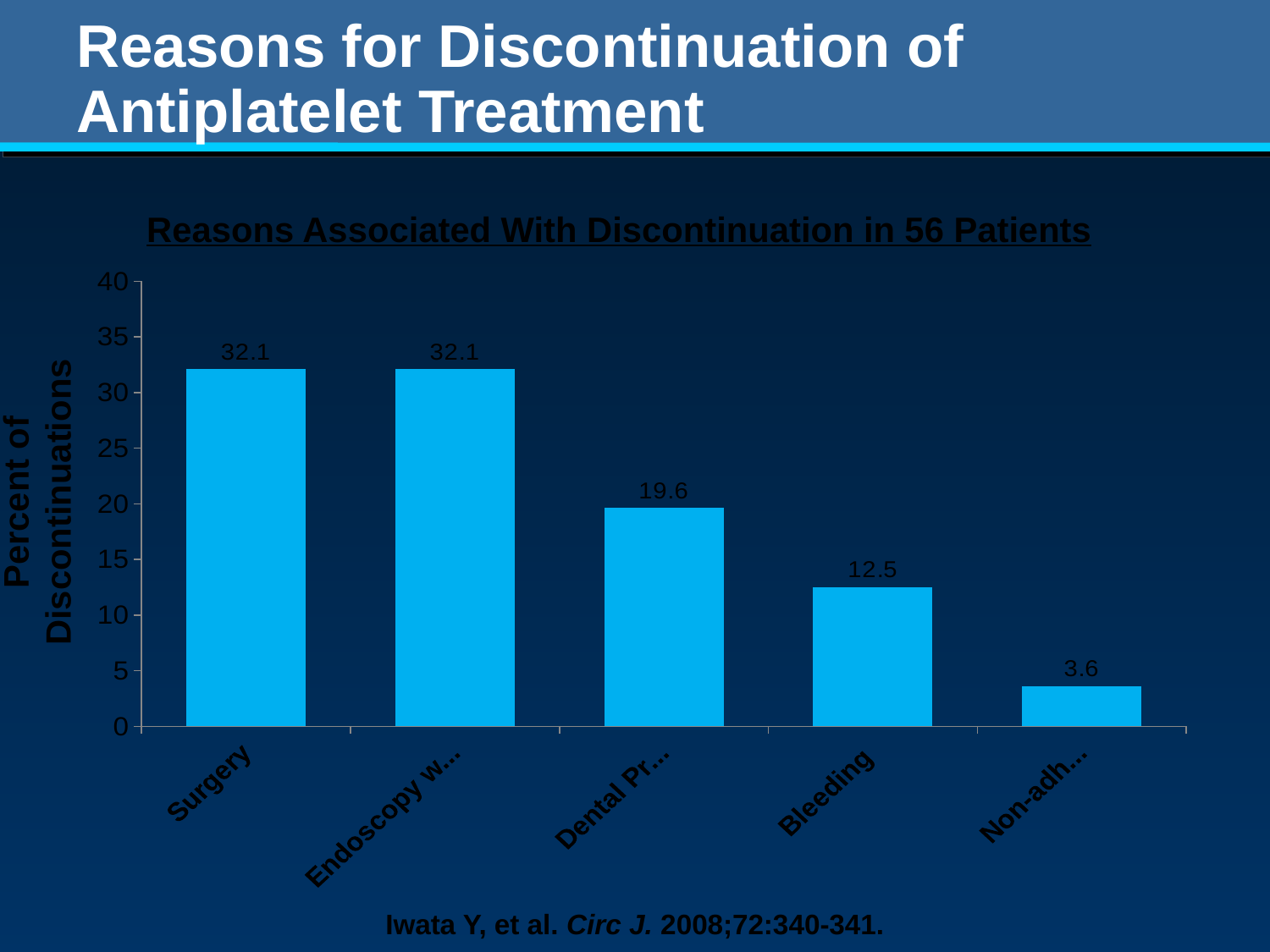
What is the label on the vertical axis of the chart? Percent of Discontinuations What is the lowest value shown on the chart? 3.6 Which is larger, the value for Surgery or the value for Bleeding? Surgery What is the difference between the values for Surgery and Bleeding? 19.6 What kind of chart is shown on the slide? bar chart What is the value shown for the Endoscopy bar? 32.1 Do the values rise or fall from left to right across the categories? fall How many categories are shown on the chart? 5 What is the value shown for the Dental bar? 19.6 Is the value for Bleeding greater or less than 15? less What is the value for Bleeding? 12.5 What is the value for Surgery? 32.1